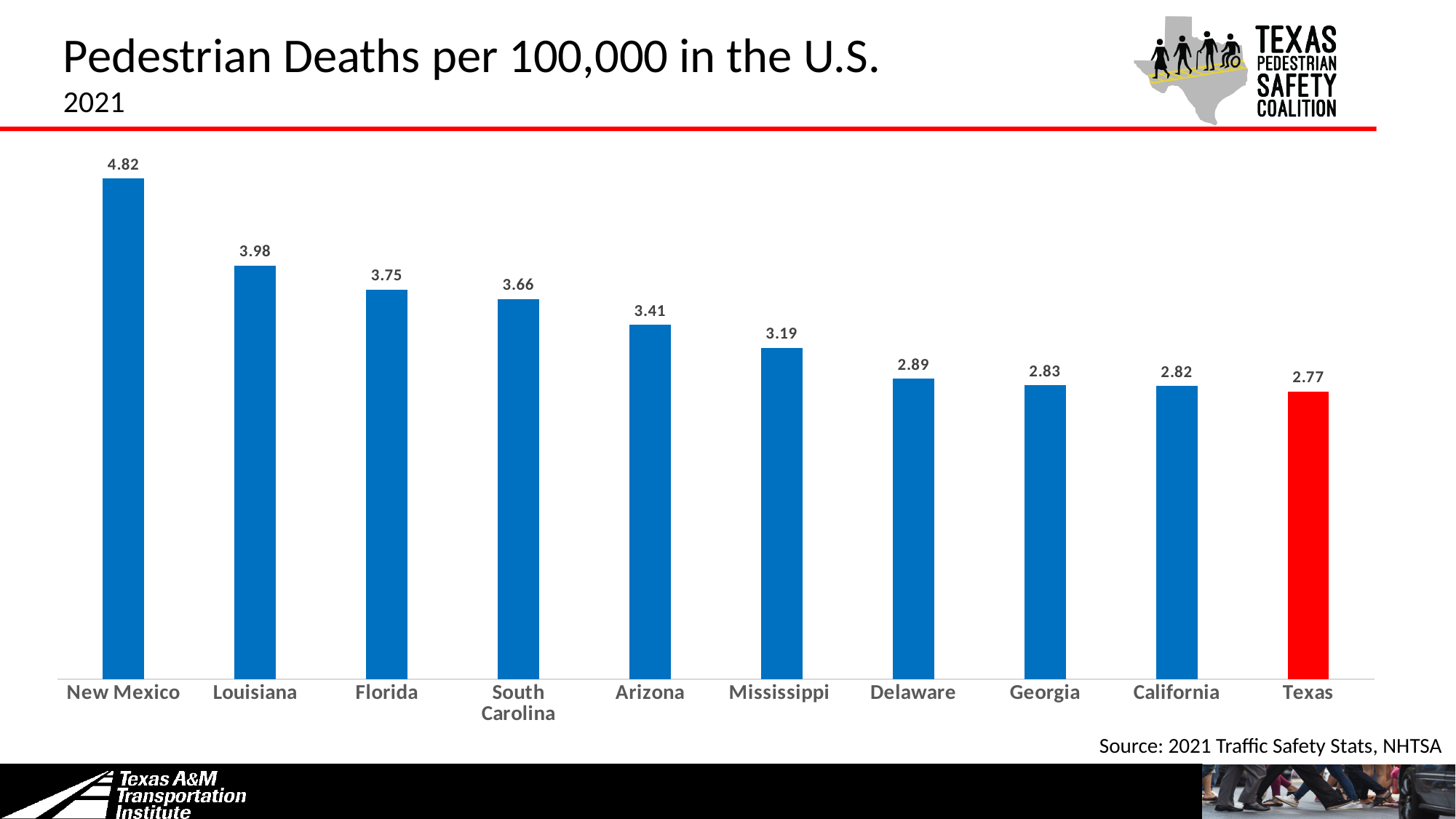
Which state has the lowest value? Texas Which state has the highest value? New Mexico What is the value for South Carolina? 3.66 What is the difference between the values for Louisiana and Florida? 0.23 Which has a larger value, Mississippi or Delaware? Mississippi Which bar is coloured red instead of blue? Texas What kind of chart is shown? Bar chart What is the difference between the values for New Mexico and Texas? 2.05 How many states are shown on the chart? 10 What is the value for Arizona? 3.41 What is the value for Texas? 2.77 What is the value for New Mexico? 4.82